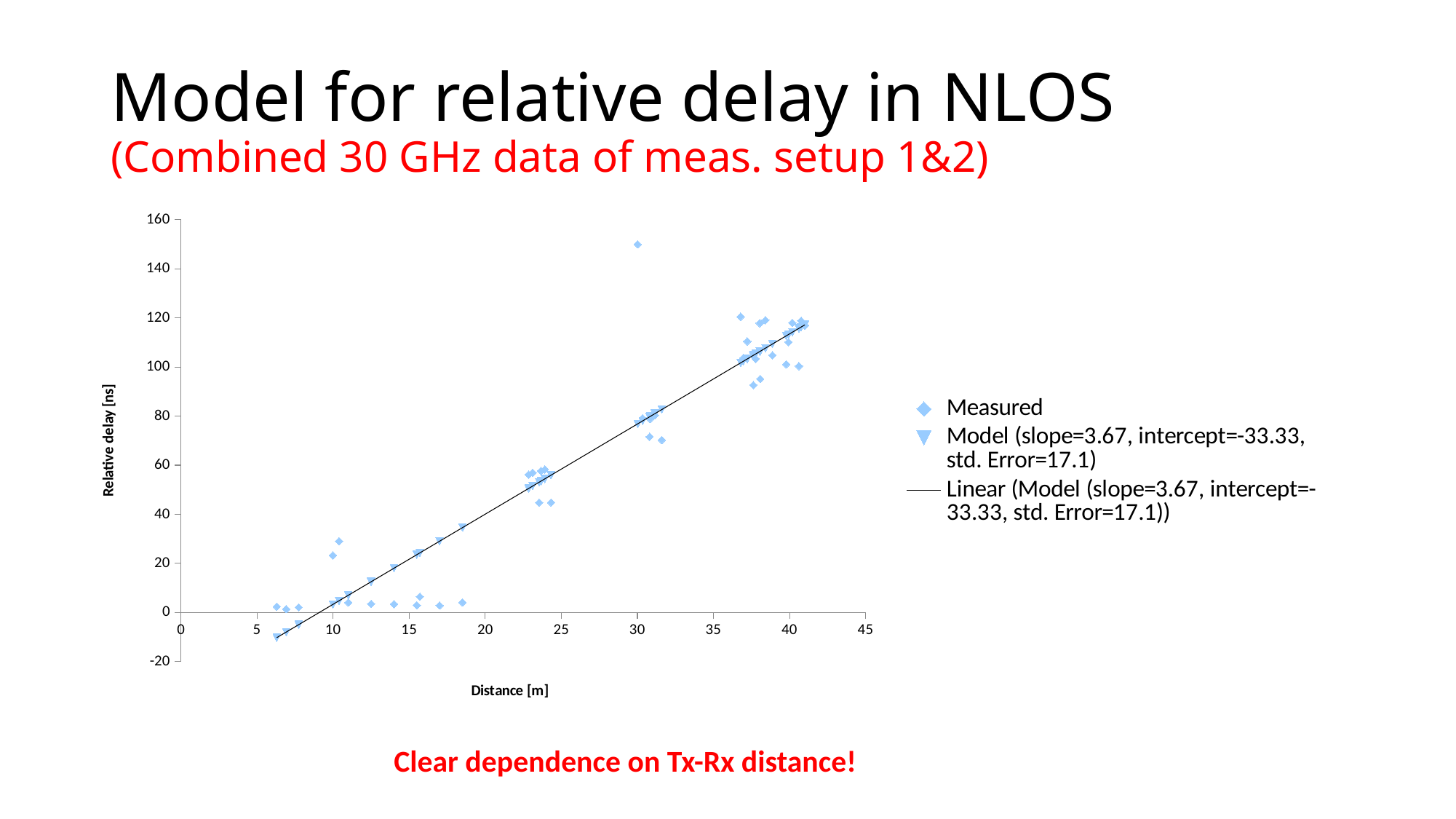
Do the measured relative delay values rise or fall as distance increases along the x axis? rise What kind of chart is shown on the slide? scatter chart How many series does the legend list? 3 Is the highest measured relative delay value (near 30 m) greater or less than 140? greater Are the measured relative delay values at about 10 m greater or less than 40? less What intercept does the legend give for the model? -33.33 Are the measured relative delay values at about 40 m greater or less than 80? greater What slope does the legend give for the model? 3.67 Which has larger measured relative delay values: the points at about 40 m or the points at about 10 m? the points at about 40 m